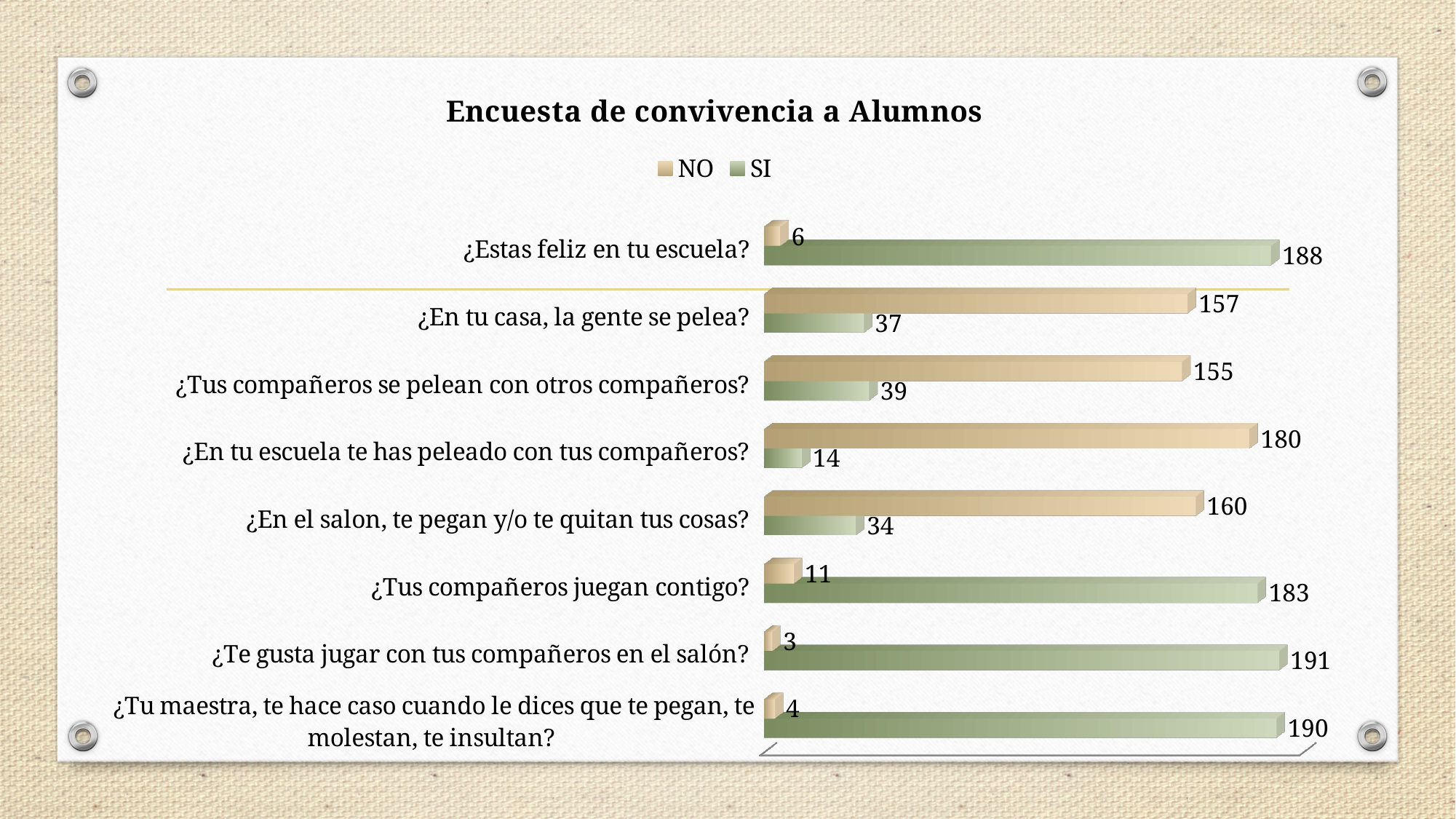
What is the difference between the NO and SI values for "¿En tu casa, la gente se pelea?"? 120 Which question has the highest SI value? ¿Te gusta jugar con tus compañeros en el salón? For "¿Tus compañeros juegan contigo?", which is larger, the NO value or the SI value? SI How many questions (categories) are shown in the chart? 8 Which question has the lowest NO value? ¿Te gusta jugar con tus compañeros en el salón? What is the title of the chart? Encuesta de convivencia a Alumnos What kind of chart is shown on the slide? Bar chart What is the NO value for "¿En tu escuela te has peleado con tus compañeros?"? 180 What is the total of the NO and SI values for "¿Tus compañeros se pelean con otros compañeros?"? 194 What is the SI value for "¿Estas feliz en tu escuela?"? 188 What is the SI value for "¿En el salon, te pegan y/o te quitan tus cosas?"? 34 How many series does the legend list? 2